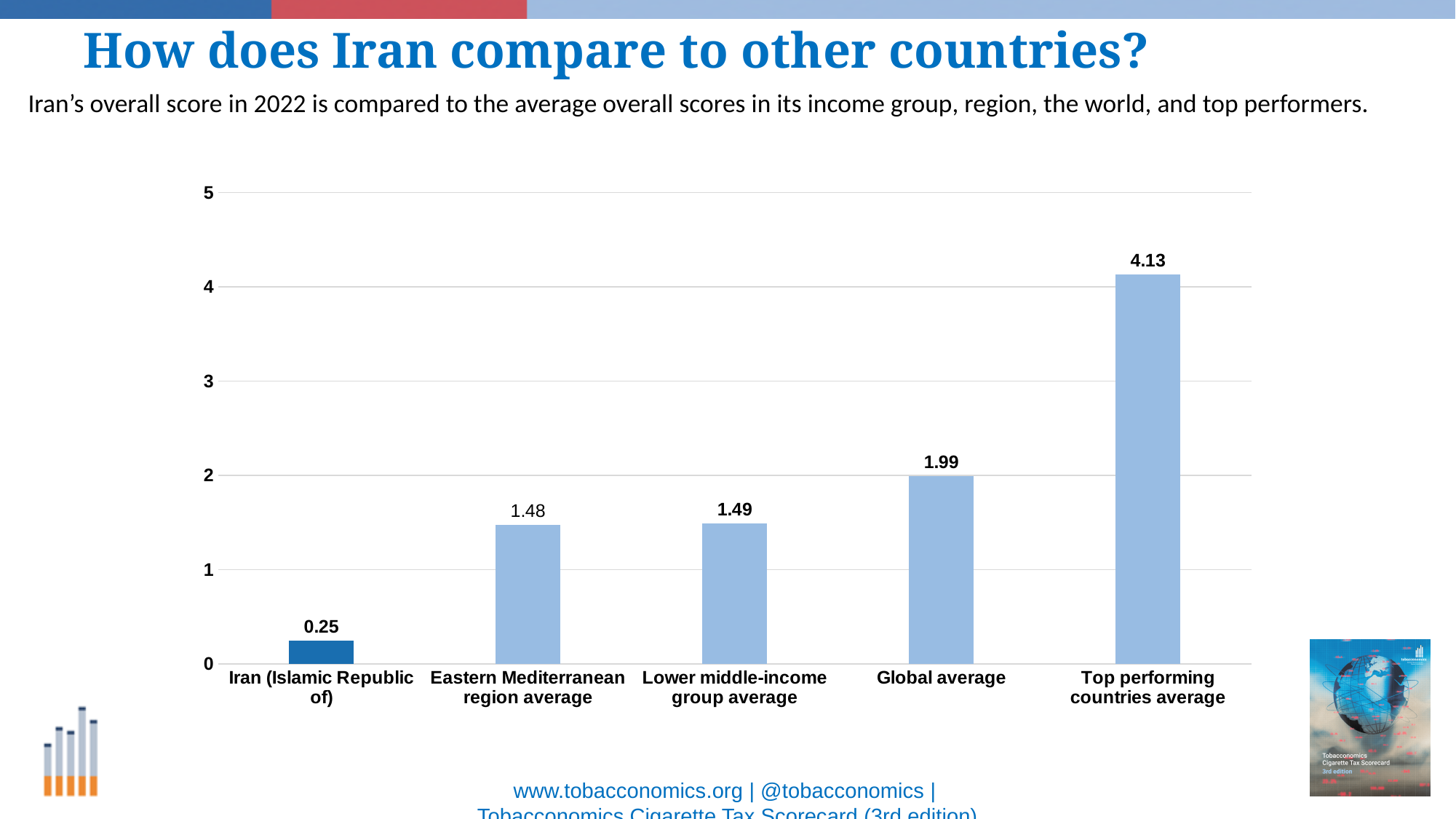
What kind of chart is shown on the slide? Bar chart Which category has the lowest value? Iran (Islamic Republic of) Which category has the highest value? Top performing countries average What is the value for Iran (Islamic Republic of)? 0.25 What is the value for the Lower middle-income group average? 1.49 What is the difference between the Global average and the Eastern Mediterranean region average? 0.51 How many categories are shown in the chart? 5 Which is larger, the Global average or the Lower middle-income group average? Global average What is the difference between the Top performing countries average and Iran (Islamic Republic of)? 3.88 What is the value for the Eastern Mediterranean region average? 1.48 What is the value for the Global average? 1.99 What is the value for the Top performing countries average? 4.13